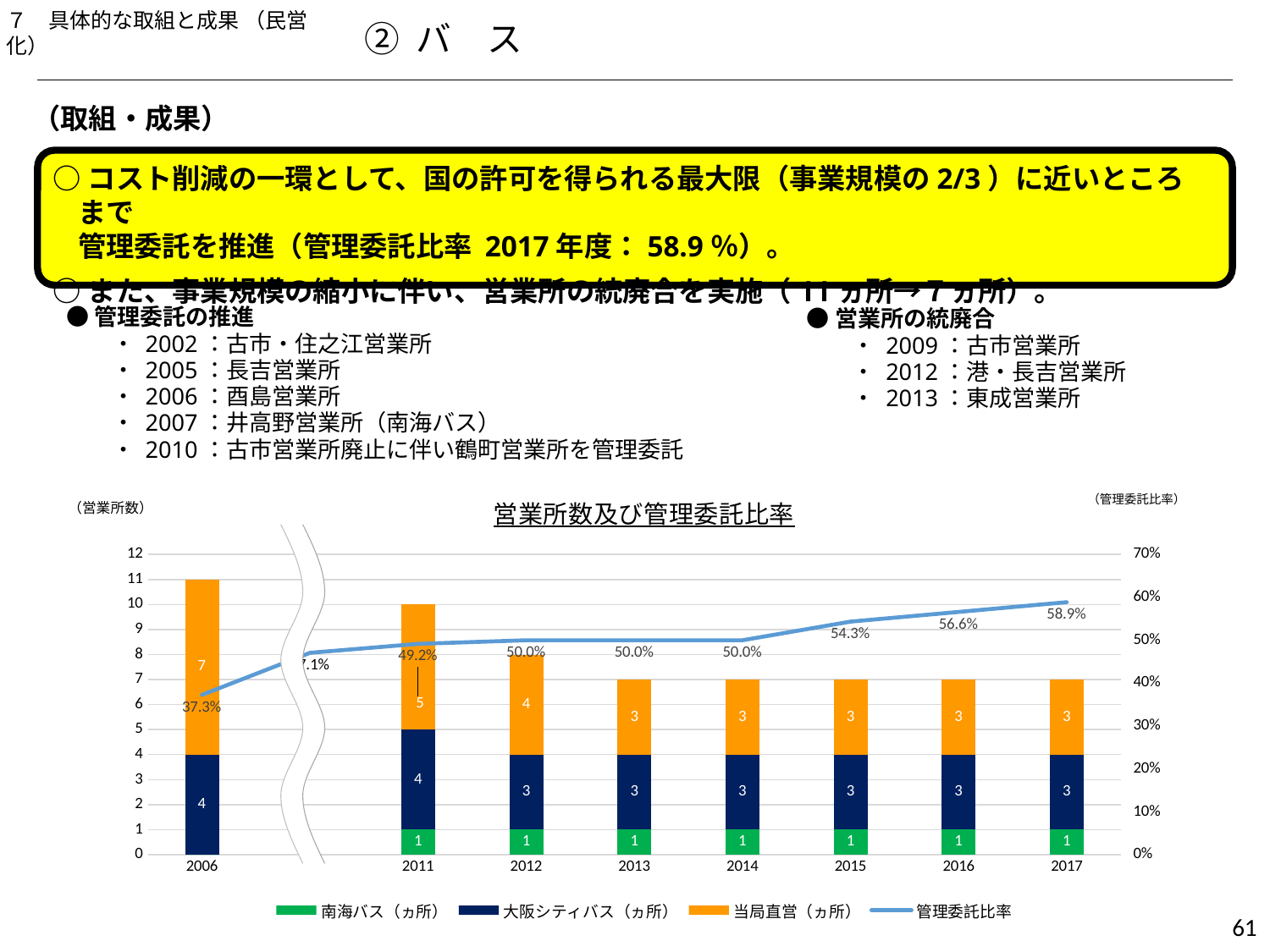
What is the difference between the 当局直営（ヵ所） value in 2006 and in 2012? 3 What is the total number of 営業所 shown by the stacked bar for 2017? 7 How many years are shown on the x axis of the chart? 8 What is the value of 当局直営（ヵ所） in 2006? 7 What is the total number of 営業所 shown by the stacked bar for 2011? 10 What is the 管理委託比率 value for 2015? 54.3% Does the 管理委託比率 line rise or fall from 2014 to 2017? rise Which year has the highest 管理委託比率? 2017 What is the 管理委託比率 value for 2017? 58.9% What is the title of the chart? 営業所数及び管理委託比率 What is the value of 大阪シティバス（ヵ所） in 2011? 4 How many series does the chart legend list? 4